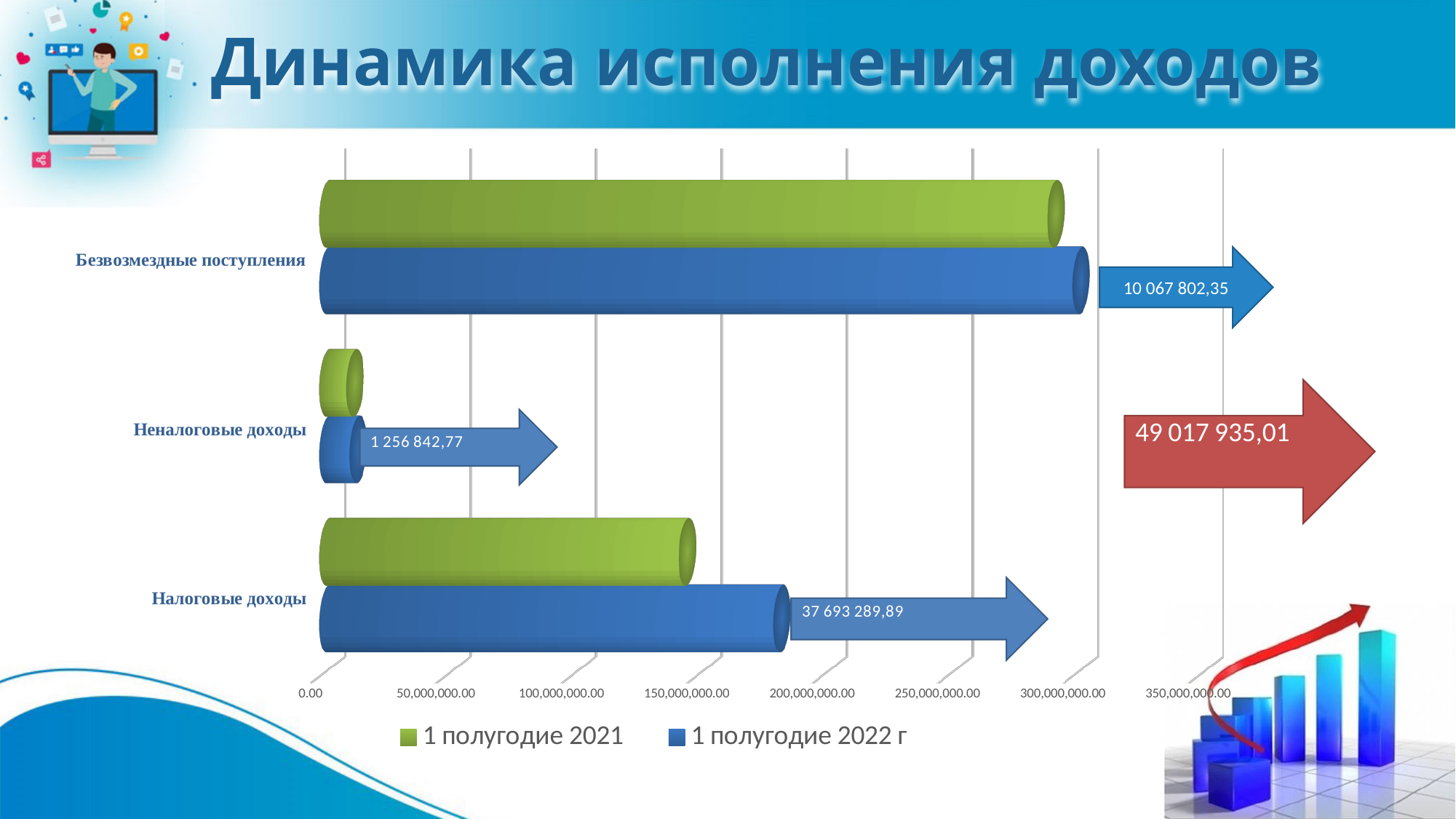
What kind of chart is shown on the slide? bar chart How many series does the legend list? 2 Is the value for Налоговые доходы in 1 полугодие 2021 greater or less than 100,000,000.00? greater Is the value for Безвозмездные поступления in 1 полугодие 2022 г greater or less than 250,000,000.00? greater Is the value for Неналоговые доходы in 1 полугодие 2021 greater or less than 50,000,000.00? less Which category has the highest value for the series 1 полугодие 2022 г? Безвозмездные поступления Which category has the lowest value for the series 1 полугодие 2021? Неналоговые доходы What is the title of the slide chart? Динамика исполнения доходов For Налоговые доходы, which series has the larger value: 1 полугодие 2021 or 1 полугодие 2022 г? 1 полугодие 2022 г How many categories are plotted on the chart? 3 What value is printed in the large red arrow on the right of the chart? 49 017 935,01